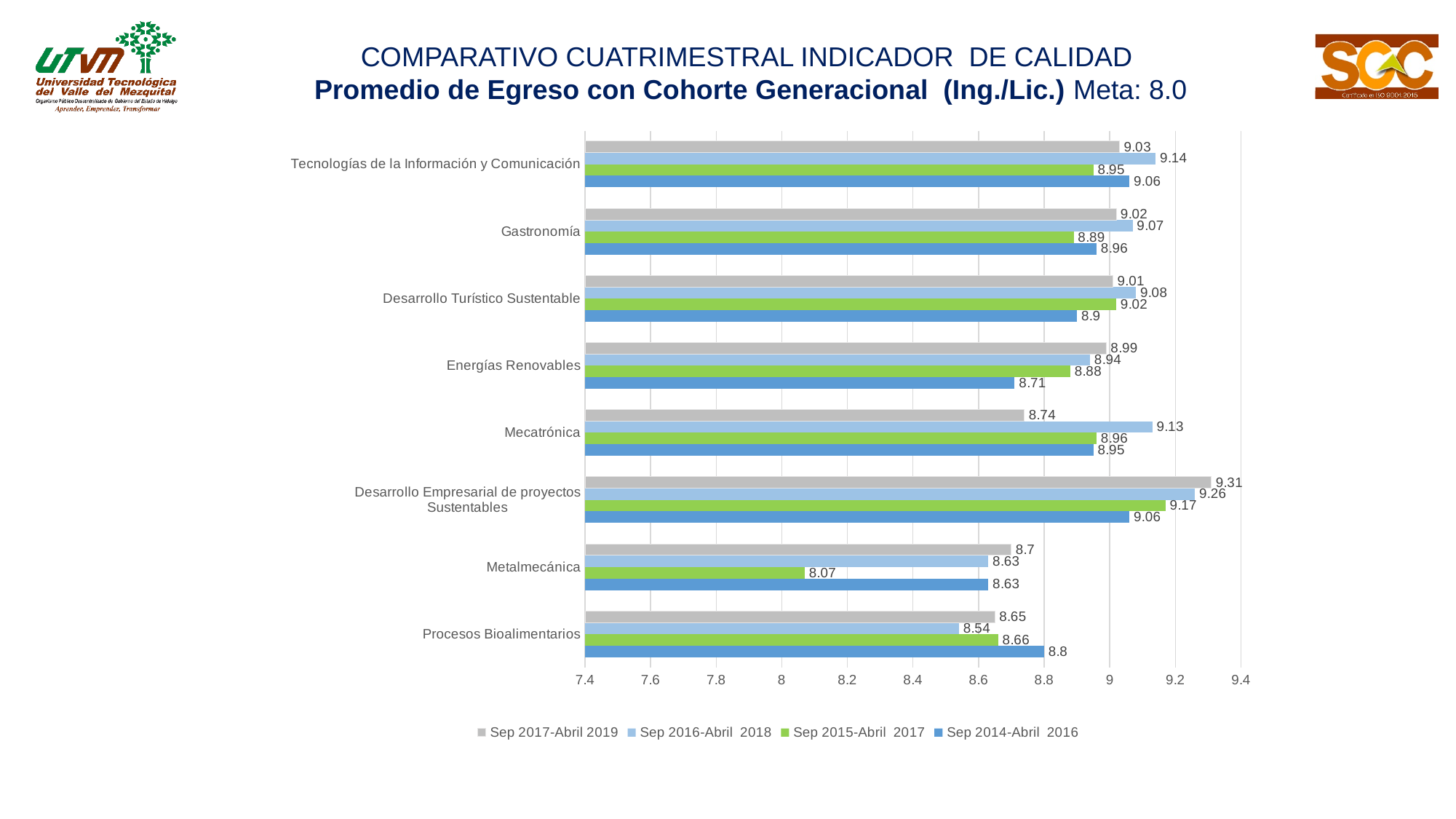
Which category has the highest value in the Sep 2017-Abril 2019 series? Desarrollo Empresarial de proyectos Sustentables What is the value for Metalmecánica in the Sep 2015-Abril 2017 series? 8.07 What is the value for Mecatrónica in the Sep 2016-Abril 2018 series? 9.13 Which category has the lowest value in the Sep 2016-Abril 2018 series? Procesos Bioalimentarios Is the Sep 2015-Abril 2017 value for Metalmecánica greater or less than 8.2? less What kind of chart is shown on the slide? Bar chart What target (Meta) is stated in the chart title? 8.0 What is the value for Procesos Bioalimentarios in the Sep 2014-Abril 2016 series? 8.8 What is the difference between the Sep 2017-Abril 2019 and Sep 2014-Abril 2016 values for Energías Renovables? 0.28 How many categories (programs) are shown on the chart? 8 Which is larger for Gastronomía: the Sep 2016-Abril 2018 value or the Sep 2015-Abril 2017 value? Sep 2016-Abril 2018 How many series does the legend list? 4